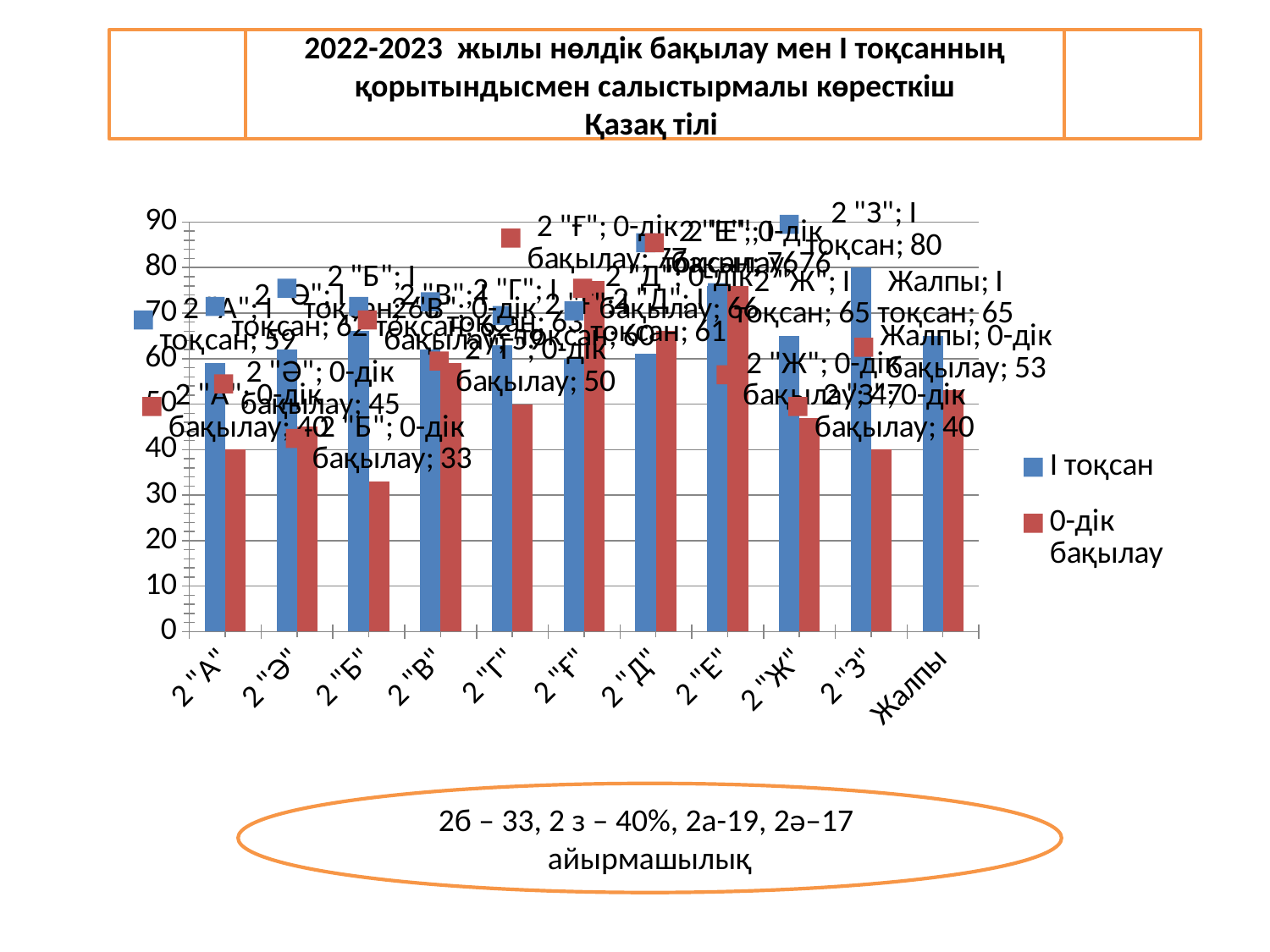
How many series does the legend list? 2 Which category has the lowest 0-дік бақылау value? 2 "Б" What is the 0-дік бақылау value for 2 "Б"? 33 What is the difference between the I тоқсан and 0-дік бақылау values for 2 "З"? 40 Is the 0-дік бақылау value for 2 "Ғ" greater or less than 70? greater Which category has the highest I тоқсан value? 2 "З" What is the I тоқсан value for 2 "А"? 59 For 2 "Ж", which is larger: the I тоқсан value or the 0-дік бақылау value? I тоқсан What is the 0-дік бақылау value for Жалпы? 53 How many categories are shown on the x axis? 11 What kind of chart is shown on the slide? bar chart What is the I тоқсан value for 2 "З"? 80